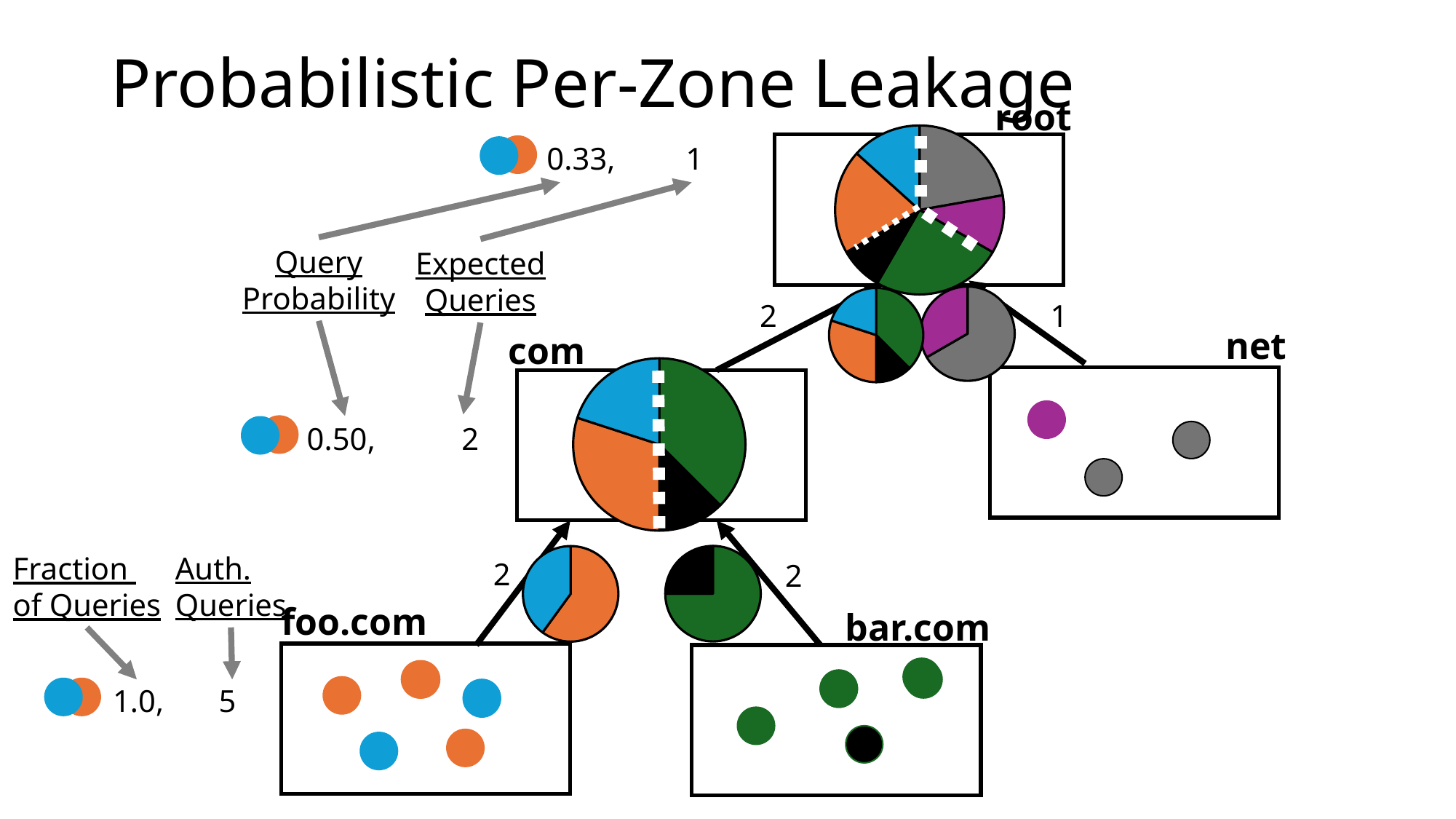
What 'Expected Queries' value is printed next to the 'Query Probability' value of 0.50? 2 What number is printed on the edge connecting 'foo.com' to 'com'? 2 What number is printed on the edge connecting 'com' to 'root'? 2 What number is printed on the edge connecting 'net' to 'root'? 1 How many labelled zone boxes (root, com, net, foo.com, bar.com) are shown on the slide? 5 What 'Auth. Queries' value is printed next to the 'Fraction of Queries' value of 1.0? 5 How many coloured dots are shown inside the 'bar.com' box? 4 What kind of chart is drawn inside the box labelled 'root'? pie chart Which box contains more dots, 'foo.com' or 'net'? foo.com How many coloured dots are shown inside the 'foo.com' box? 5 What 'Query Probability' value is printed next to the 'Expected Queries' value of 1? 0.33